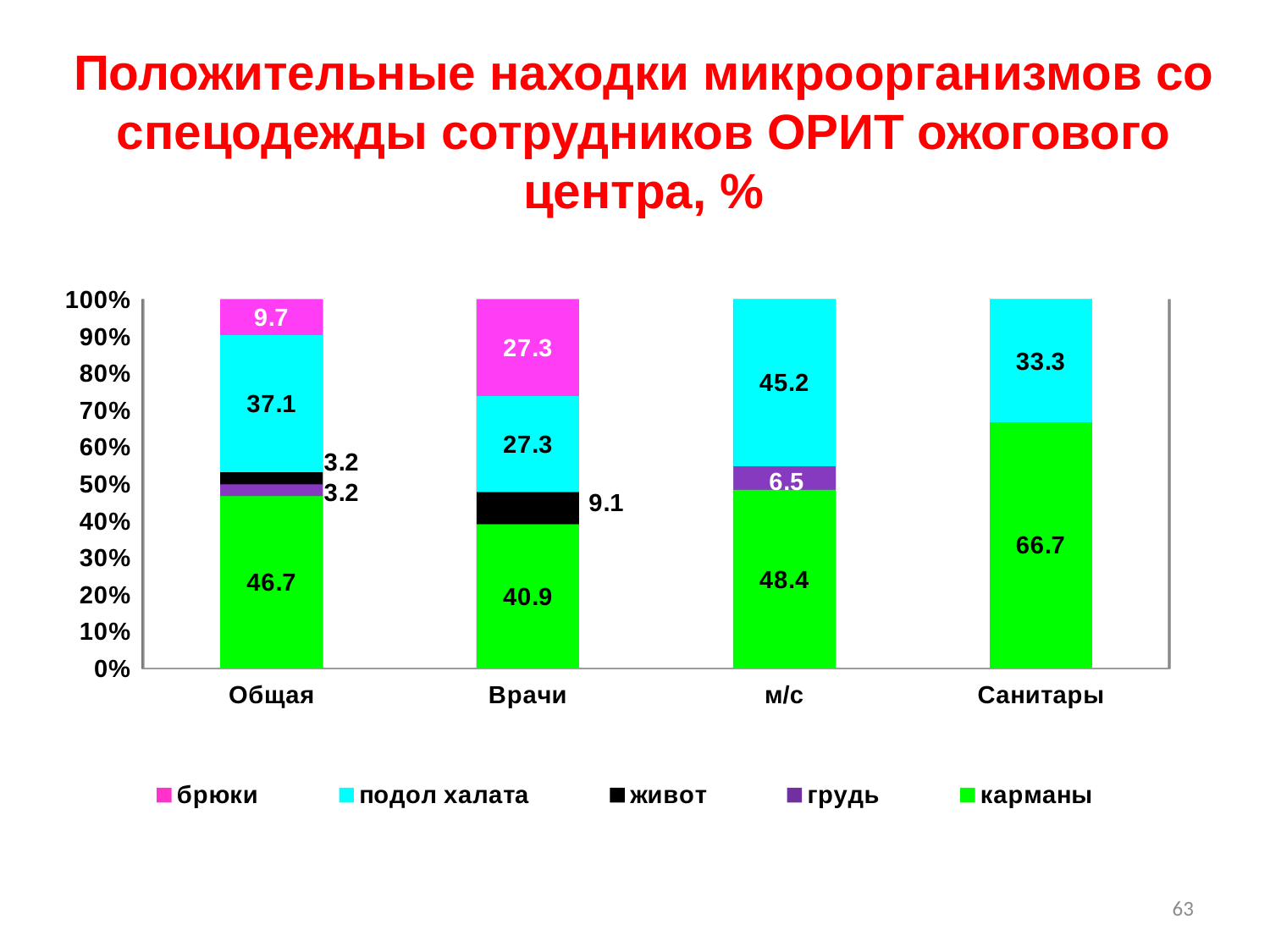
What is the value for живот in the Врачи bar? 9.1 What is the difference between the карманы values for Санитары and Общая? 20.0 Which is larger: the подол халата value for Общая or for Врачи? Общая What is the value for карманы in the Санитары bar? 66.7 What kind of chart is shown on the slide? Stacked bar chart How many categories are shown on the x axis? 4 Which category has the highest value for карманы? Санитары What is the value for грудь in the м/с bar? 6.5 What is the value for подол халата in the м/с bar? 45.2 What is the value for брюки in the Врачи bar? 27.3 How many series does the legend list? 5 Which category has the lowest value for карманы? Врачи